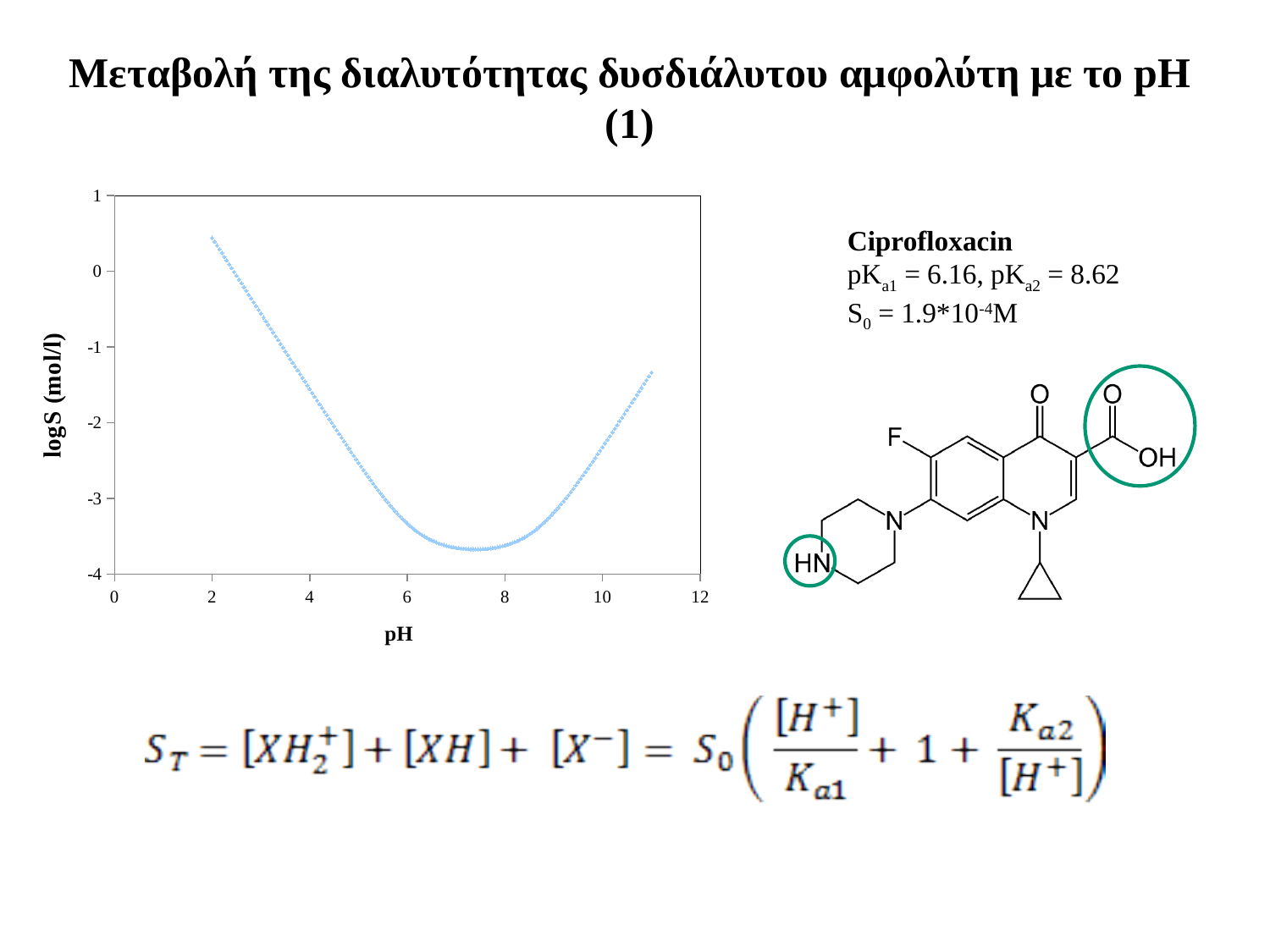
What kind of chart is shown on the slide? scatter chart Between pH 2 and pH 7, does logS rise or fall as pH increases? fall Between pH 8 and pH 11, does logS rise or fall as pH increases? rise Is the value of logS at pH 2 greater or less than 0? greater Is the value of logS at pH 7 greater or less than -3? less Is the value of logS at pH 11 greater or less than -2? greater Which has the higher logS value, pH 2 or pH 11? pH 2 What is the label of the x axis of the chart? pH What is the label of the y axis of the chart? logS (mol/l) Which has the lower logS value, pH 7 or pH 3? pH 7